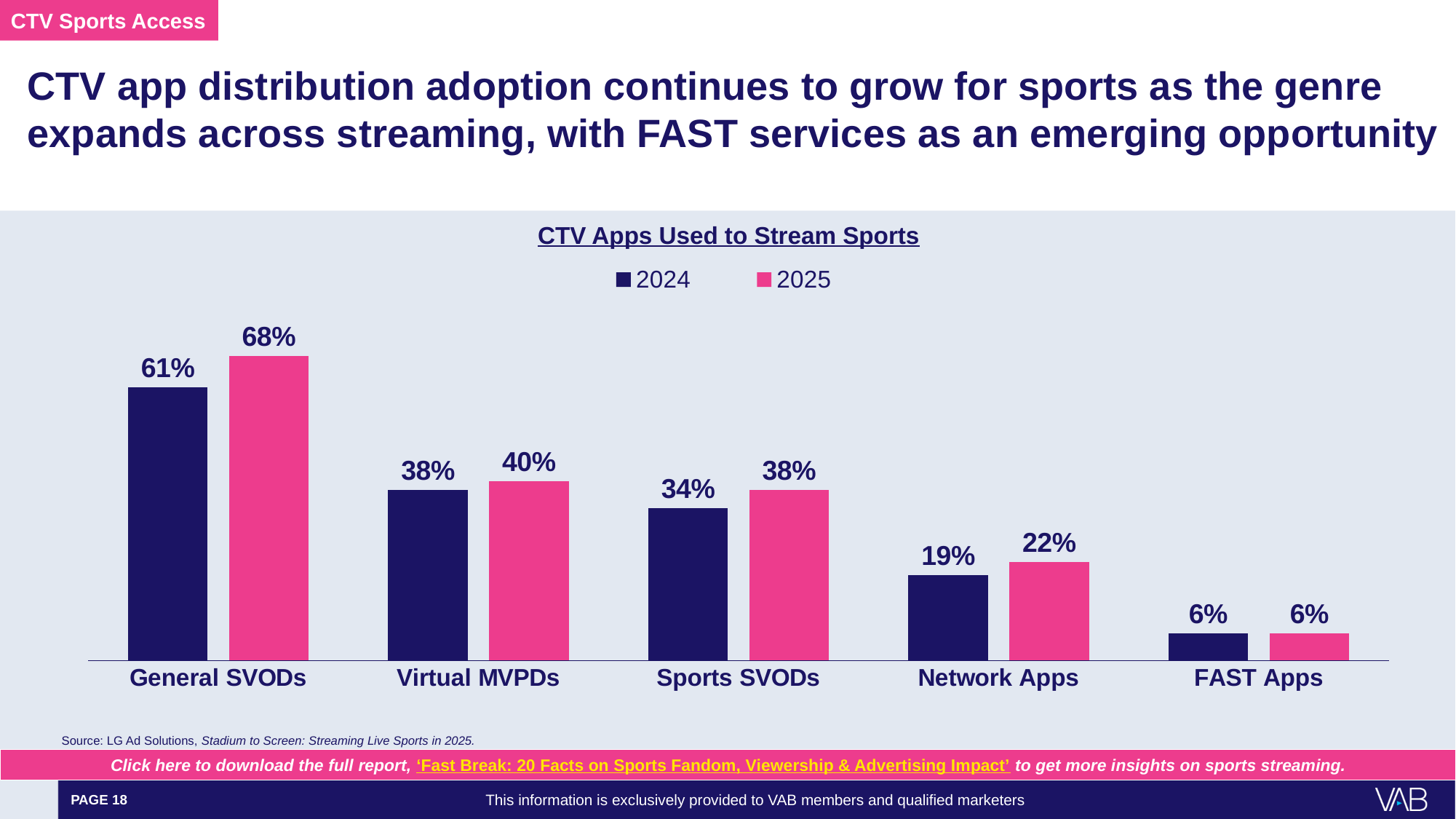
How many categories are shown on the x axis? 5 What is the 2024 value for Network Apps? 19% What is the 2025 value for Sports SVODs? 38% What is the difference between the 2025 and 2024 values for Sports SVODs? 4% What is the difference between the 2025 and 2024 values for General SVODs? 7% What kind of chart is shown? Bar chart Which category has the highest 2025 value? General SVODs How many series does the legend list? 2 What is the 2025 value for General SVODs? 68% What is the title of the chart? CTV Apps Used to Stream Sports Which is larger: the 2024 value for Virtual MVPDs or the 2024 value for Sports SVODs? Virtual MVPDs Which category has the lowest 2024 value? FAST Apps